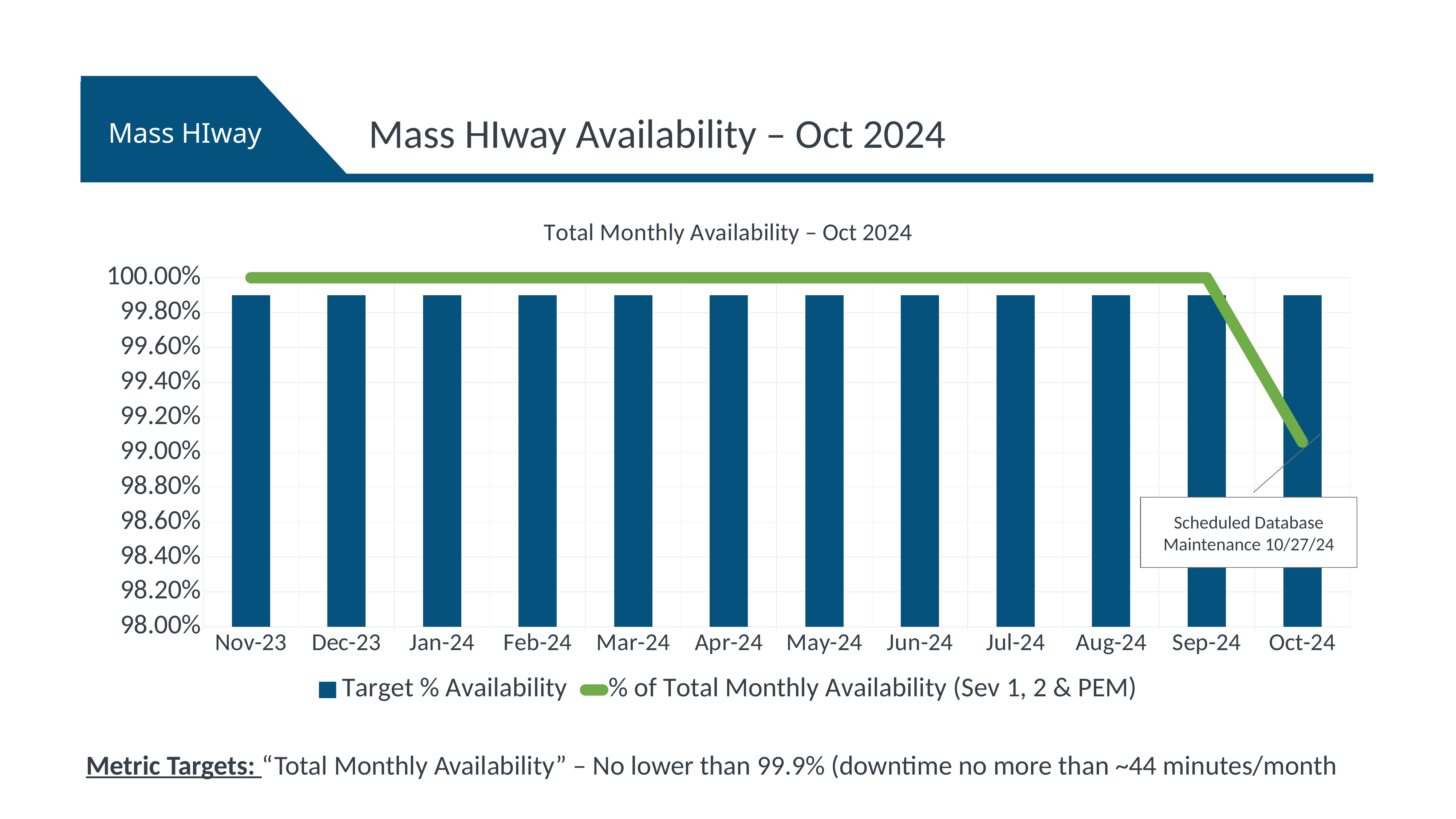
How many months are shown on the x axis of the chart? 12 Which is larger, the % of Total Monthly Availability (Sev 1, 2 & PEM) for Sep-24 or for Oct-24? Sep-24 What kind of chart is shown on the slide? bar and line chart Does the % of Total Monthly Availability (Sev 1, 2 & PEM) line rise or fall from Sep-24 to Oct-24? fall Is the % of Total Monthly Availability (Sev 1, 2 & PEM) for Oct-24 greater or less than 98.80%? greater How many series does the chart legend list? 2 What is the % of Total Monthly Availability (Sev 1, 2 & PEM) for Sep-24? 100.00% Which month has the lowest % of Total Monthly Availability (Sev 1, 2 & PEM)? Oct-24 What is the title of the chart? Total Monthly Availability – Oct 2024 Is the Target % Availability bar for Jan-24 greater or less than 99.80%? greater What is the % of Total Monthly Availability (Sev 1, 2 & PEM) for Nov-23? 100.00% Is the % of Total Monthly Availability (Sev 1, 2 & PEM) for Oct-24 greater or less than 99.40%? less